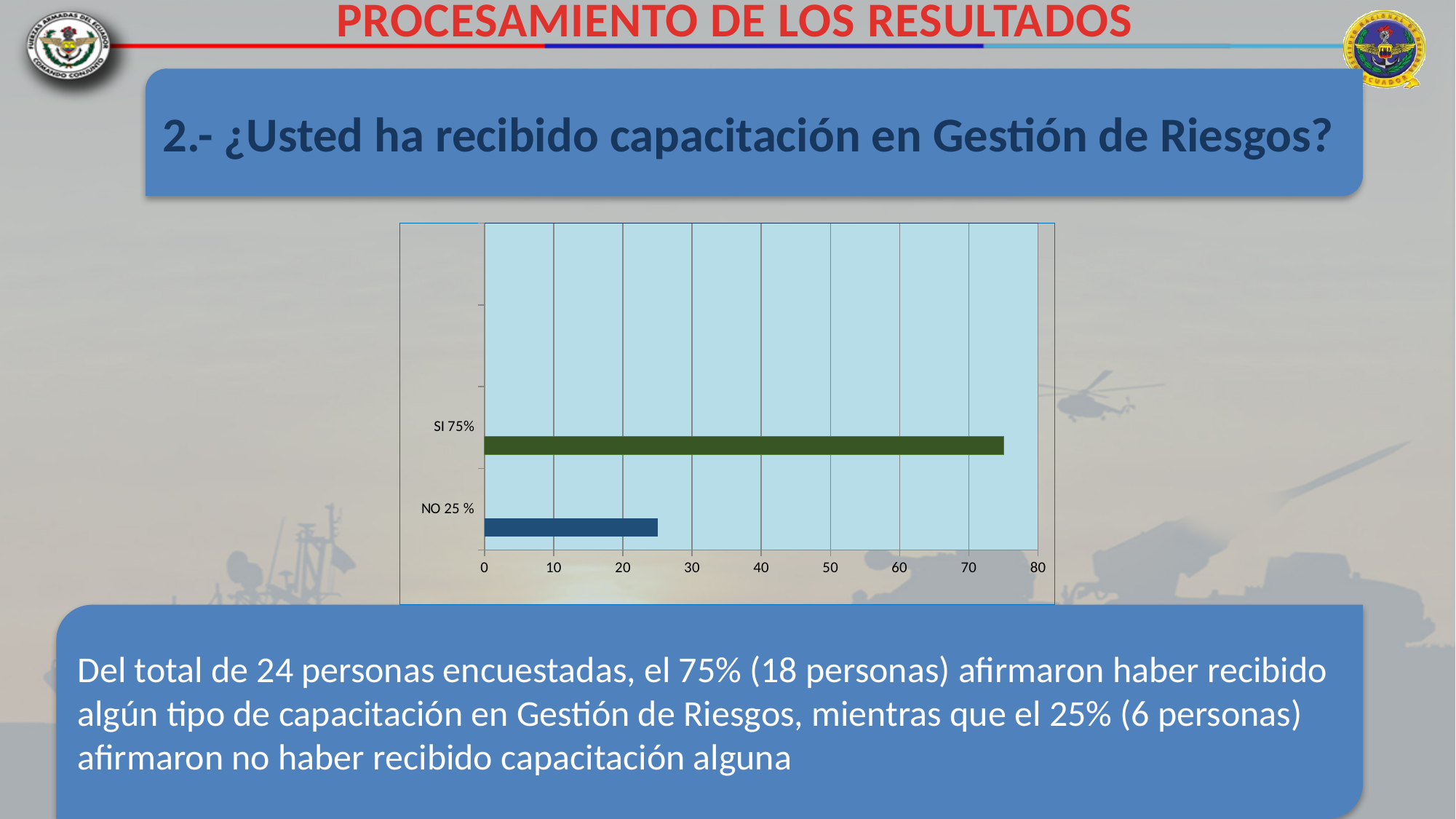
What kind of chart is shown on the slide? bar chart Which is larger, the value for SI or the value for NO? SI Is the value for SI greater or less than 70? greater What is the difference between the SI value and the NO value? 50% What is the highest value shown on the horizontal axis? 80 Is the value for NO greater or less than 30? less What colour is the bar for the SI category? green How many categories does the chart show? 2 What percentage is shown for the SI category? 75% Which category has the shortest bar? NO 25 % What percentage is shown for the NO category? 25 % Which category has the longest bar? SI 75%